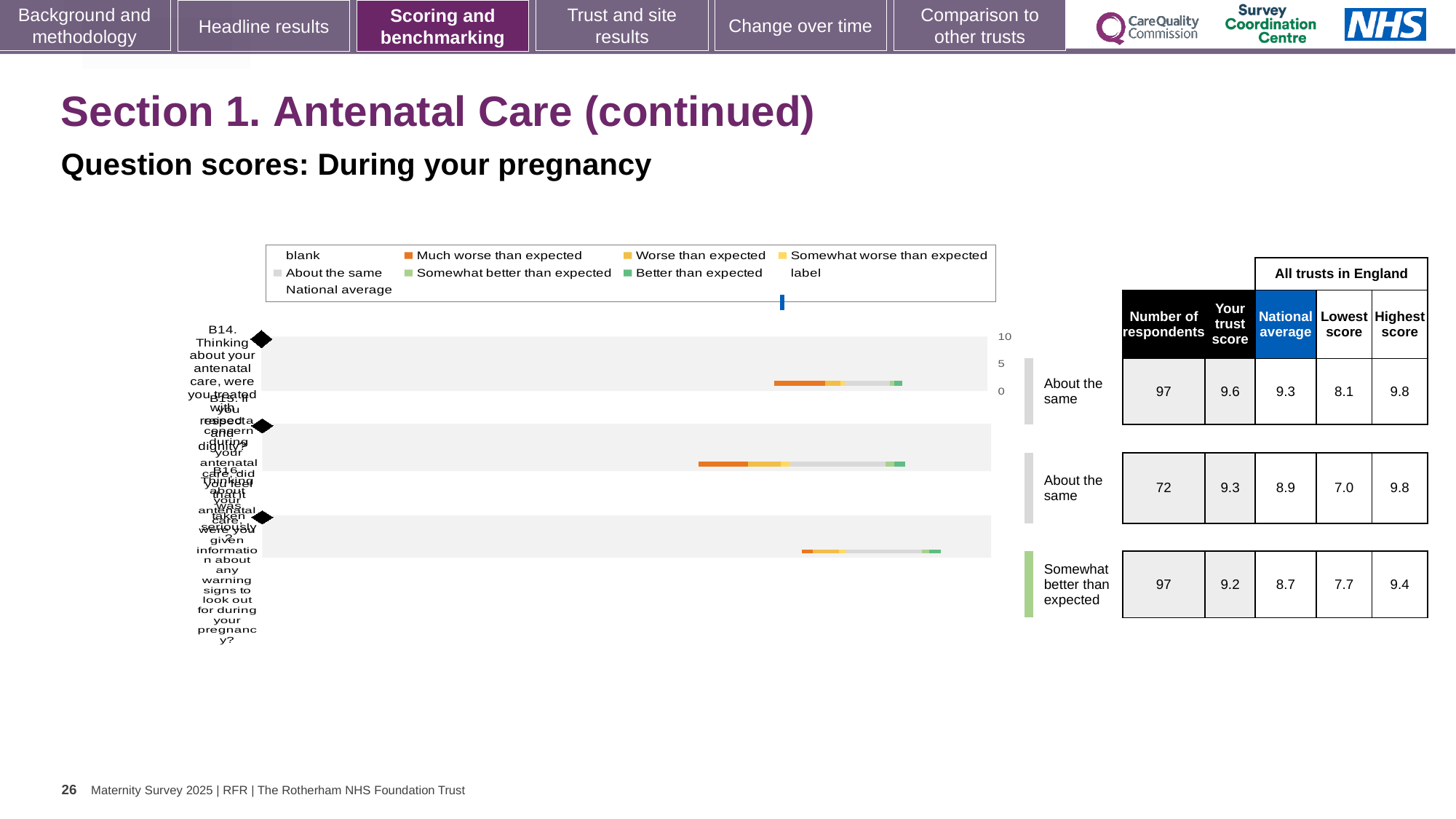
In the table beside the chart, what is the national average for the second row? 8.9 How many question bars are plotted in the chart? 3 Which legend entry in the chart is shown in orange? Much worse than expected In the table beside the chart, which benchmark label is given for the third row? Somewhat better than expected What kind of chart is shown on the slide? bar chart In the table beside the chart, which row has the highest trust score? the first row (B14) What is the highest tick value shown on the chart's axis? 10 In the table beside the chart, how many respondents are listed for the second row? 72 In the table beside the chart, what is the difference between the trust score and the national average in the third row? 0.5 How many entries does the chart's legend list? 9 In the table beside the chart, what is the trust score for the first row (B14)? 9.6 In the table beside the chart, what is the lowest score for the third row? 7.7